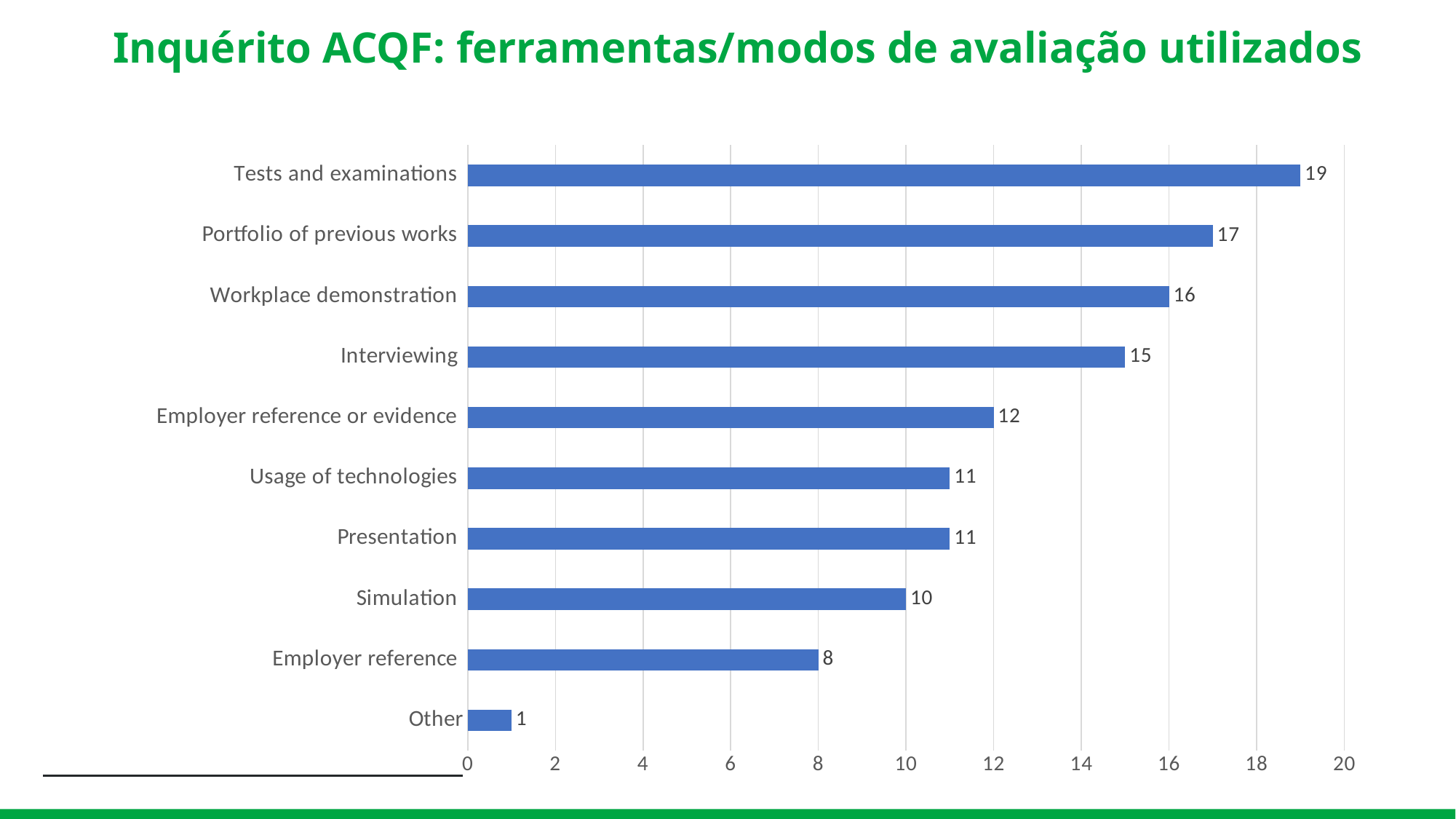
Which is larger, the value for Interviewing or the value for Usage of technologies? Interviewing What is the difference between the values for Portfolio of previous works and Interviewing? 2 Which category has the highest value? Tests and examinations What is the value for Tests and examinations? 19 What is the title of the slide? Inquérito ACQF: ferramentas/modos de avaliação utilizados How many categories are shown in the chart? 10 Is the value for Employer reference greater or less than 10? less Which category has the lowest value? Other What is the difference between the values for Workplace demonstration and Employer reference? 8 What is the value for Simulation? 10 What is the value for Employer reference or evidence? 12 What kind of chart is shown on the slide? bar chart